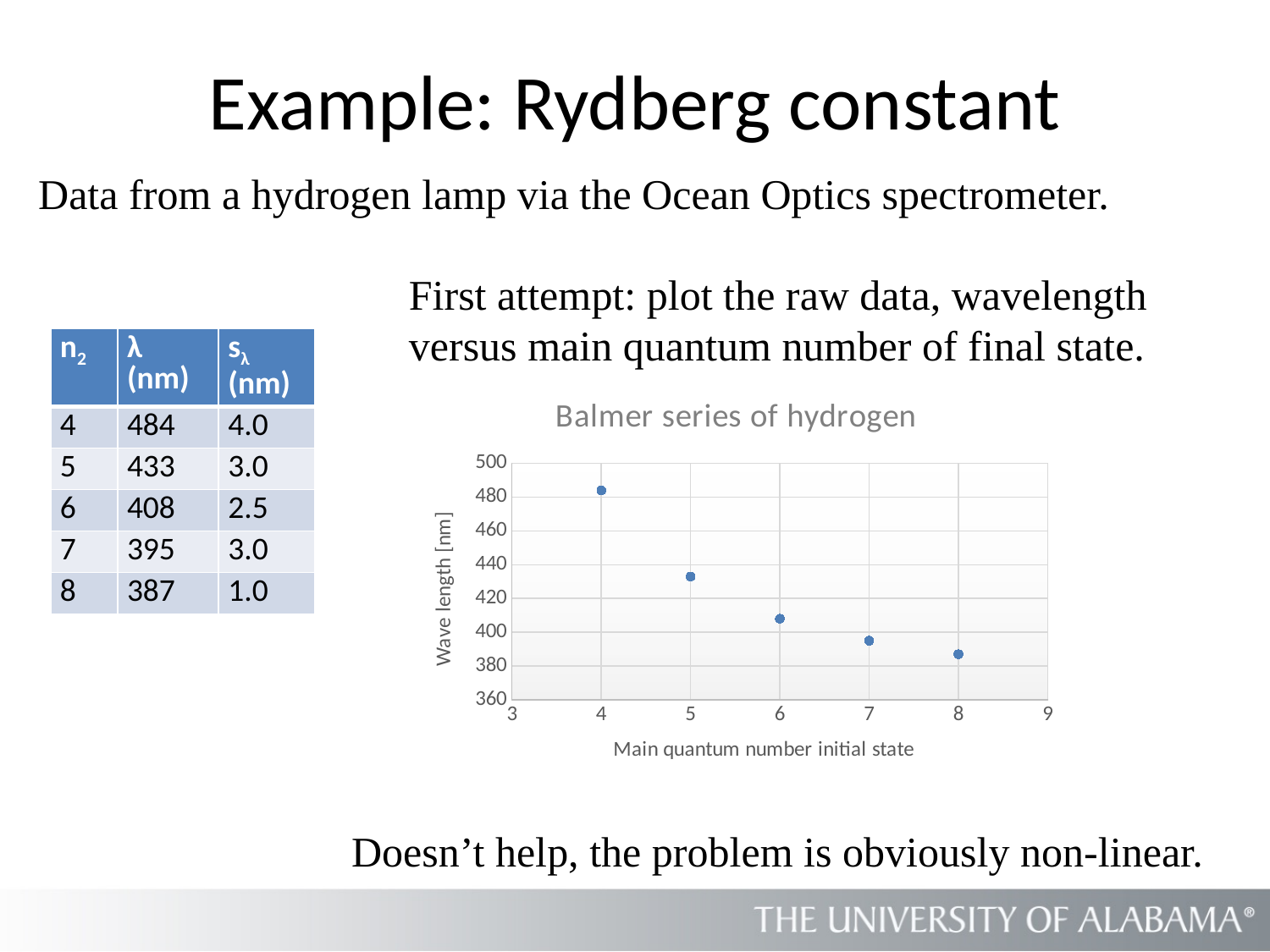
Is the wavelength plotted at main quantum number 8 greater or less than 400? less What is the label of the x axis of the chart? Main quantum number initial state At which main quantum number is the plotted wavelength lowest? 8 Do the wavelength values rise or fall as the main quantum number increases along the x axis? Fall What wavelength is plotted at main quantum number 6, as given in the table on the slide? 408 What is the title of the chart? Balmer series of hydrogen How many data points are plotted in the chart? 5 Is the wavelength plotted at main quantum number 4 greater or less than 460? greater Is the wavelength plotted at main quantum number 5 greater or less than 420? greater What kind of chart is shown on the slide? Scatter chart At which main quantum number is the plotted wavelength highest? 4 Which has the larger plotted wavelength, main quantum number 5 or main quantum number 6? 5